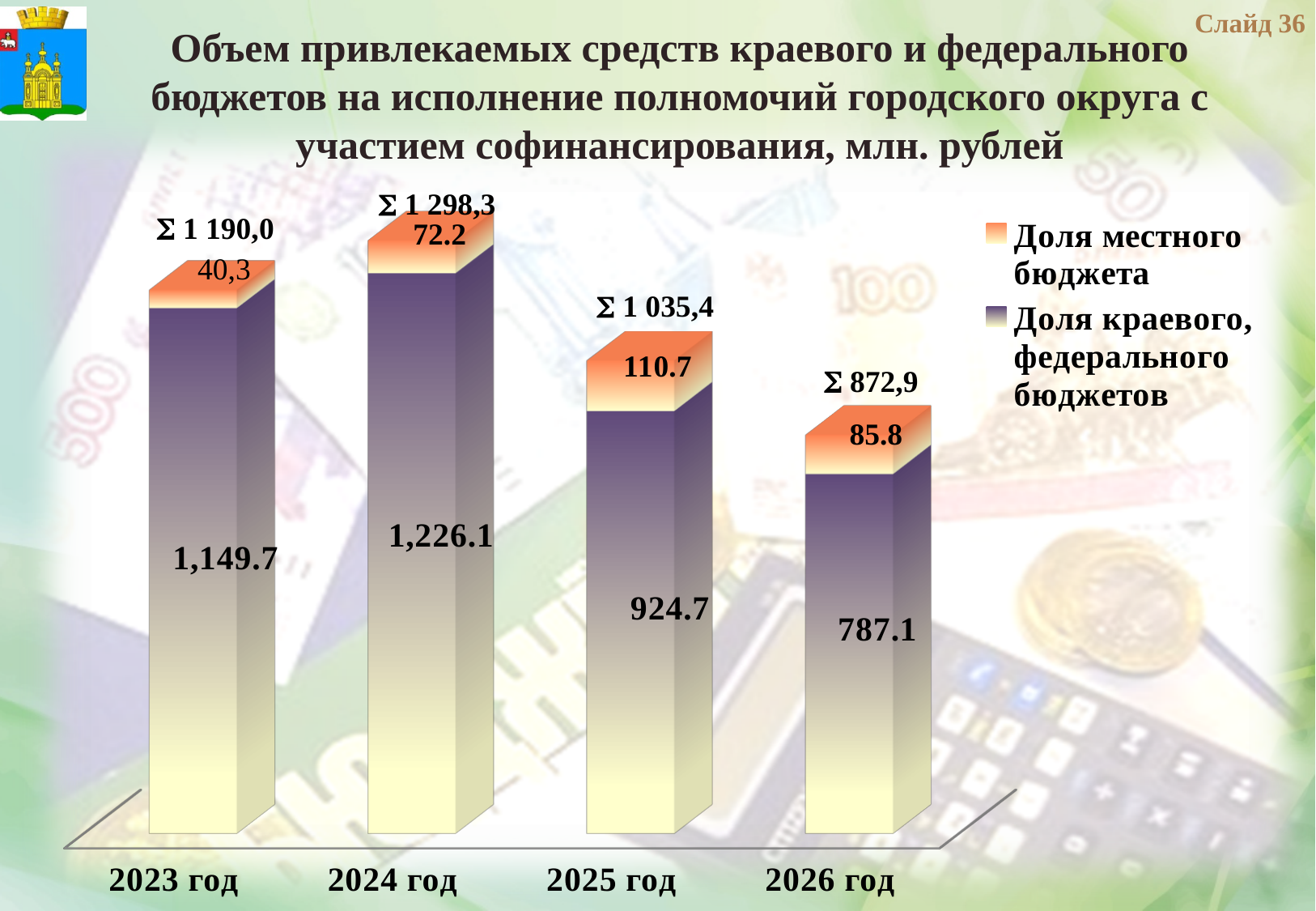
What is the total (Σ) shown above the bar for 2024 год? 1 298,3 Which year has the lowest 'Доля краевого, федерального бюджетов' value? 2026 год What is the value of the 'Доля местного бюджета' segment for 2023 год? 40,3 How many series does the legend list? 2 What is the total (Σ) shown above the bar for 2026 год? 872,9 How many years are shown on the x axis of the chart? 4 Which is larger: the 'Доля краевого, федерального бюджетов' value for 2023 год or for 2025 год? 2023 год What is the value of the 'Доля краевого, федерального бюджетов' segment for 2026 год? 787.1 What is the difference between the 'Доля местного бюджета' values for 2025 год and 2026 год? 24.9 What is the value of the 'Доля местного бюджета' segment for 2025 год? 110.7 Which year has the highest 'Доля местного бюджета' value? 2025 год What is the value of the 'Доля краевого, федерального бюджетов' segment for 2024 год? 1,226.1